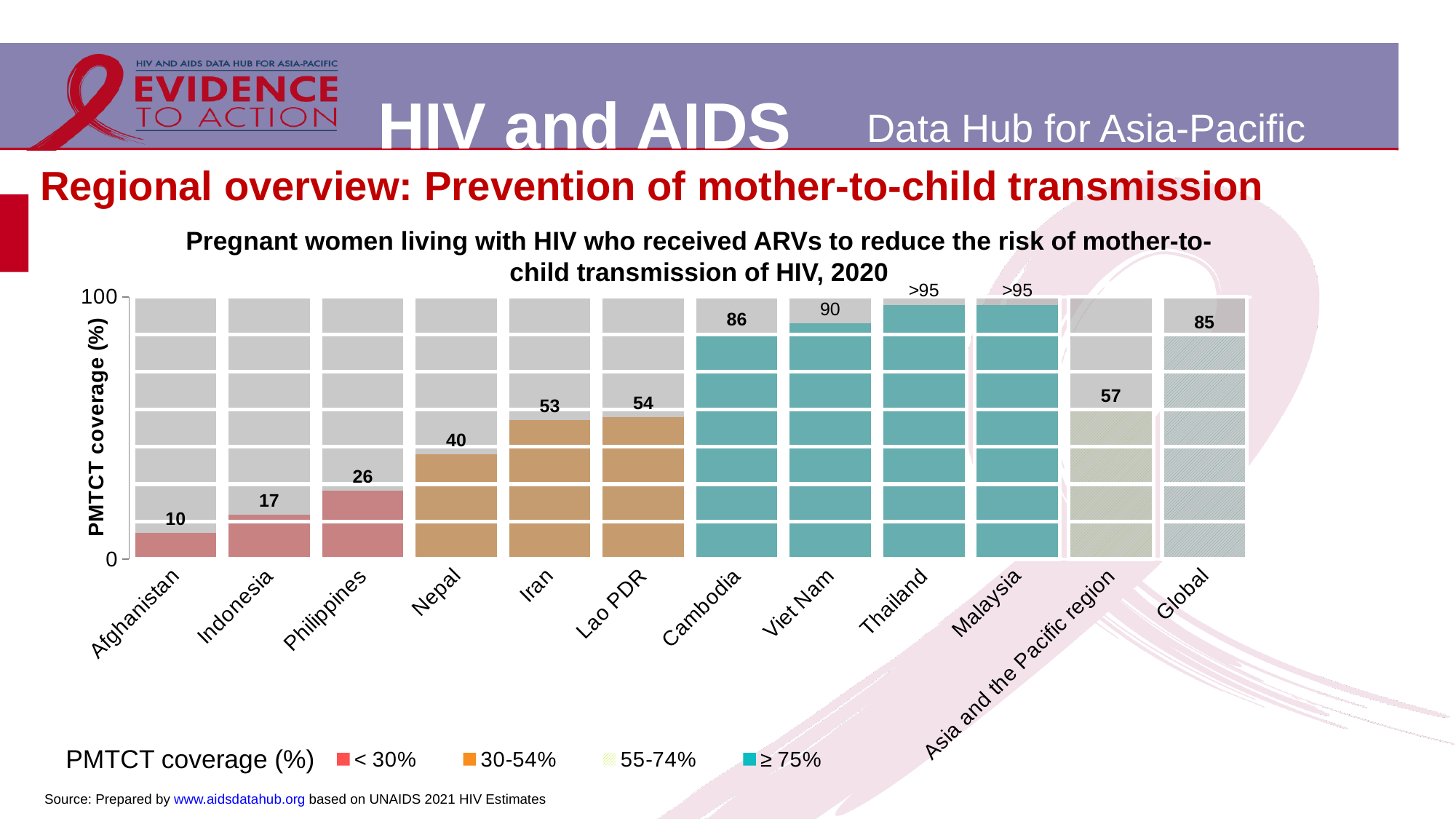
What kind of chart is shown on the slide? Bar chart What is the difference between the Global value and the Asia and the Pacific region value? 28 What is the PMTCT coverage value shown for Nepal? 40 What is the PMTCT coverage value shown for Cambodia? 86 What is the difference between the values for Viet Nam and Cambodia? 4 How many coverage ranges does the legend list? 4 How many categories (bars) are shown on the chart? 12 Which has a higher PMTCT coverage, Nepal or the Philippines? Nepal What value is shown for the Asia and the Pacific region? 57 Which year does the chart title say the data refers to? 2020 What value is shown for Thailand? >95 Which country has the lowest PMTCT coverage on the chart? Afghanistan